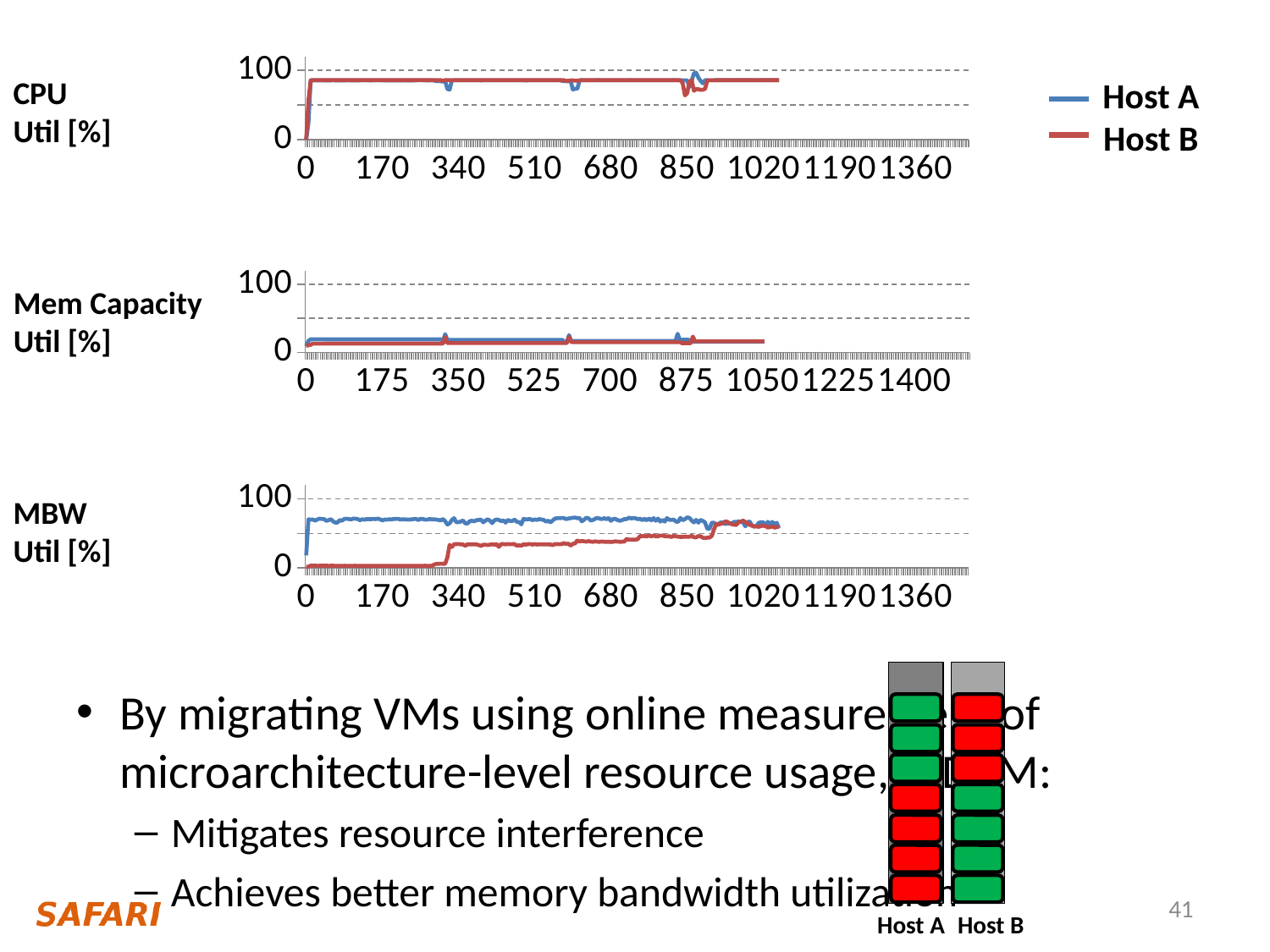
Which series is drawn in red in the charts? Host B In the CPU Util [%] chart, is the value for Host B at x = 510 greater or less than 50? greater In the MBW Util [%] chart, does the Host B line generally rise or fall along the x axis? rise In the MBW Util [%] chart, is the value for Host A at x = 170 greater or less than 50? greater What kind of chart is the CPU Util [%] chart? line chart How many series does the legend list for the charts? 2 In the MBW Util [%] chart, is the value for Host B at x = 170 greater or less than 50? less Which series is drawn in blue in the charts? Host A What is the last x-axis tick label on the Mem Capacity Util [%] chart? 1400 What is the last x-axis tick label on the CPU Util [%] chart? 1360 In the MBW Util [%] chart, which series has the larger value at x = 170, Host A or Host B? Host A